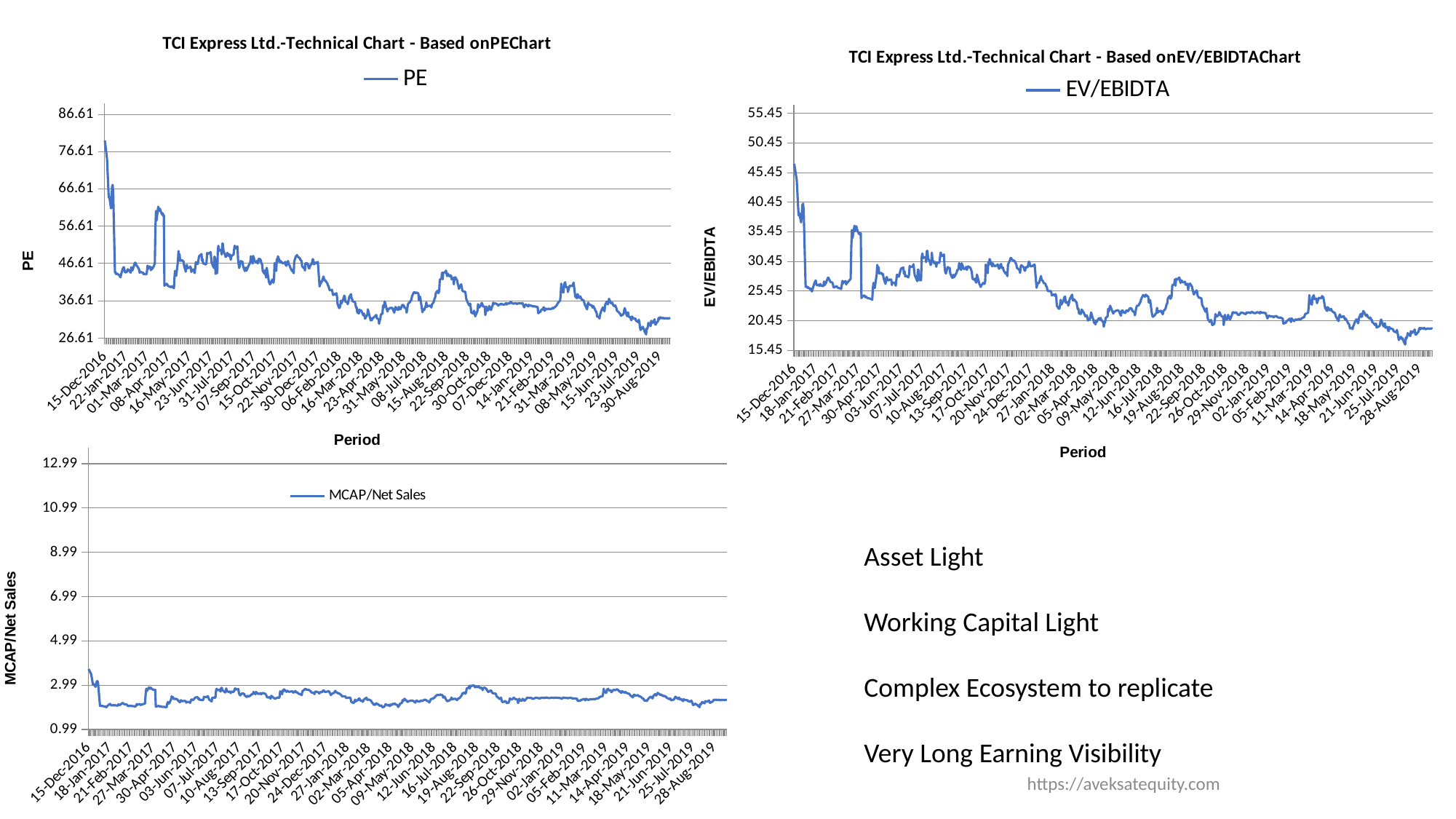
In the MCAP/Net Sales chart (bottom left), is the value at 28-Aug-2019 greater or less than 2.99? less In the PE chart (top left), is the PE value at 15-Dec-2016 greater or less than 66.61? greater In the EV/EBIDTA chart (top right), is the value at 28-Aug-2019 greater or less than 25.45? less What is the x-axis title of the 'TCI Express Ltd.-Technical Chart - Based onPEChart'? Period In the EV/EBIDTA chart (top right), does the value overall rise or fall across the period shown? fall In the PE chart (top left), does the PE value overall rise or fall from 15-Dec-2016 to 30-Aug-2019? fall What is the series name shown in the legend of the bottom-left chart? MCAP/Net Sales What kind of chart is the 'TCI Express Ltd.-Technical Chart - Based onPEChart'? line chart How many series does the legend of the 'TCI Express Ltd.-Technical Chart - Based onEV/EBIDTAChart' list? 1